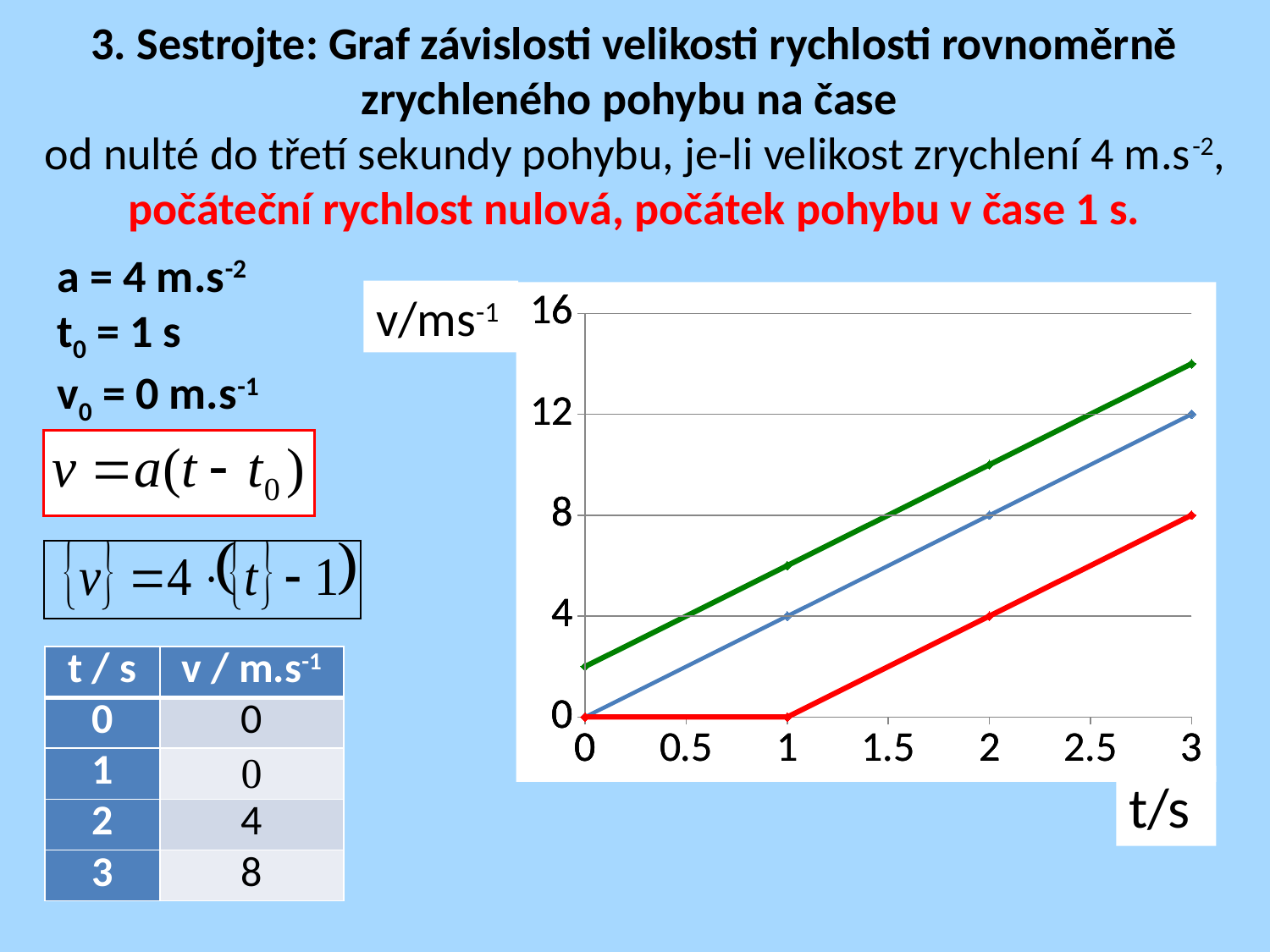
At t = 3 s, which line has the larger value, the green line or the red line? green line Which line has the highest value at t = 2 s? green line Does the red line rise or fall between t = 1 s and t = 3 s? rise Is the value of the green line at t = 3 s greater or less than 12? greater What is the value of the red line at t = 3 s? 8 What is the value of the red line at t = 1 s? 0 Is the value of the green line at t = 0 s greater or less than 4? less What is the label of the vertical axis of the chart? v/ms⁻¹ How many lines are plotted on the chart? 3 What kind of chart is shown on the slide? line chart What is the value of the blue line at t = 2 s? 8 What is the value of the blue line at t = 3 s? 12